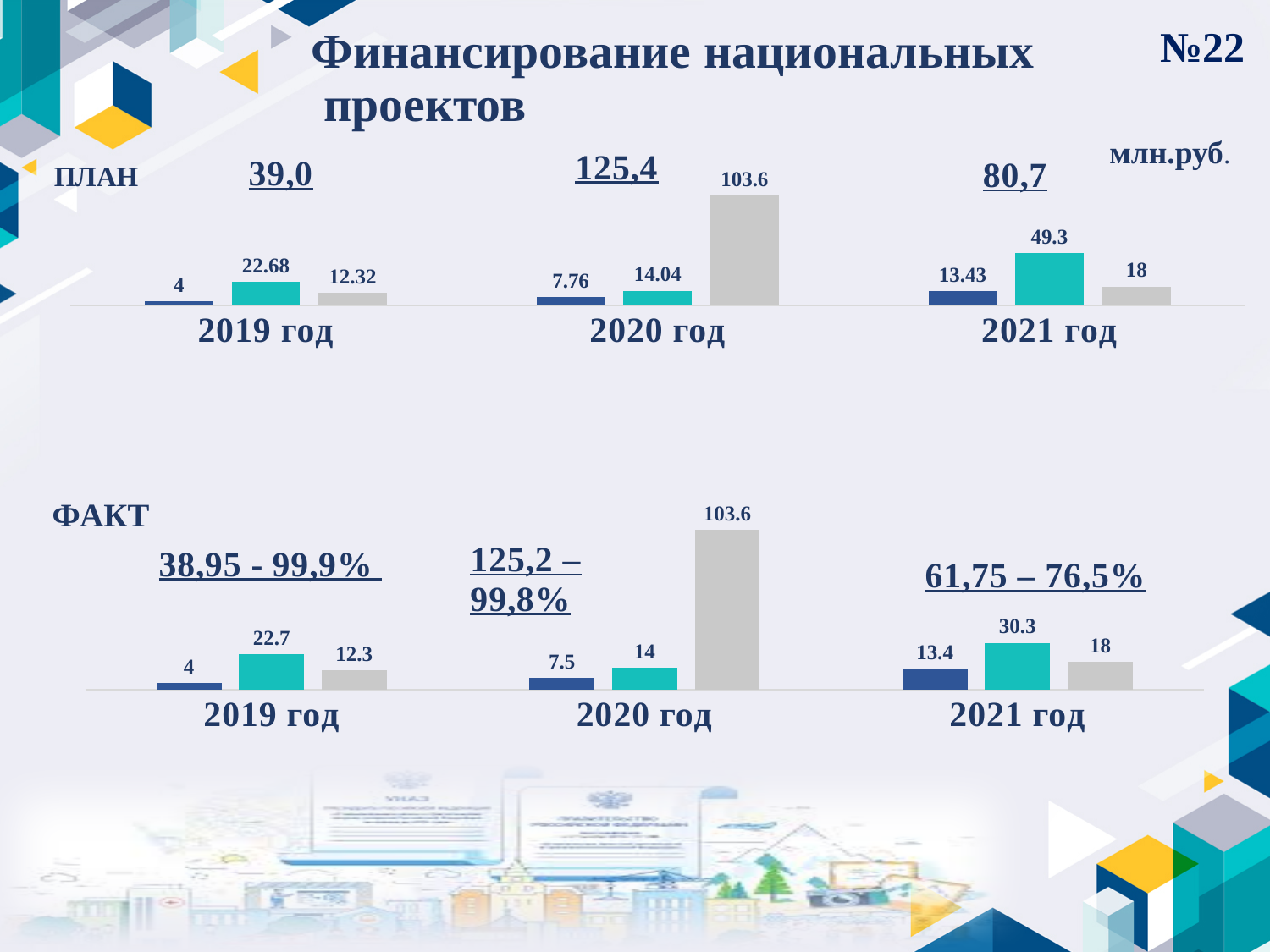
In the ФАКТ chart (bottom), which bar has the lowest value? the blue bar for 2019 год (4) How many year groups are shown in the ПЛАН chart (top)? 3 In the ФАКТ chart (bottom), what is the value of the blue bar for 2020 год? 7.5 Is the teal bar for 2021 год larger in the ПЛАН chart (top) or in the ФАКТ chart (bottom)? ПЛАН (49.3) In the ПЛАН chart (top), what is the value of the grey bar for 2020 год? 103.6 In the ФАКТ chart (bottom), what is the value of the teal bar for 2021 год? 30.3 In the ПЛАН chart (top), which year has the tallest bar? 2020 год What type of chart is the ФАКТ chart (bottom)? bar chart In the ПЛАН chart (top), do the blue bars rise or fall from 2019 год to 2021 год? rise In the ПЛАН chart (top), what is the value of the teal bar for 2019 год? 22.68 In the ПЛАН chart (top), what is the difference between the teal bar and the grey bar for 2019 год? 10.36 What unit of measurement is indicated for the charts on the slide? млн.руб.